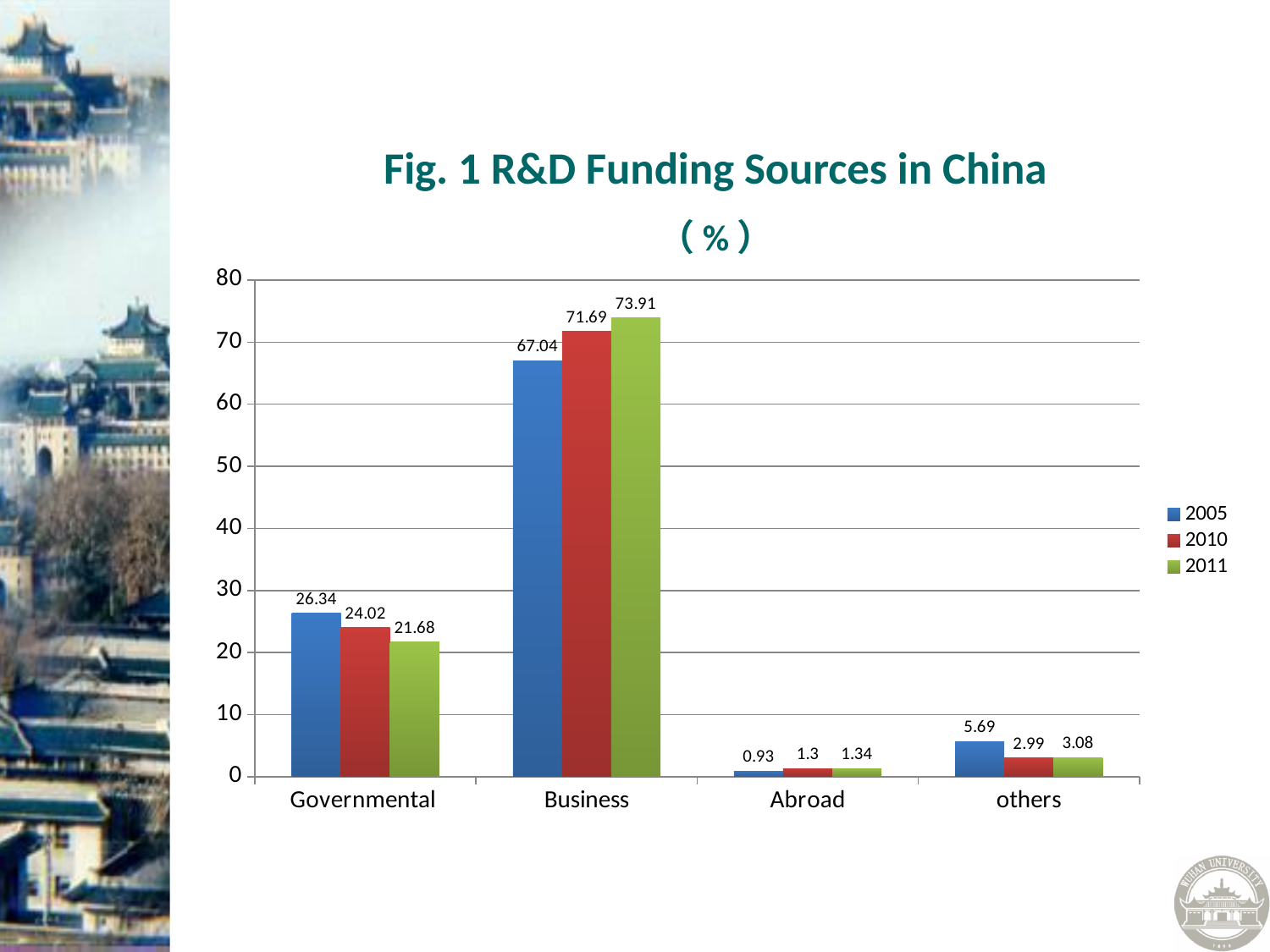
Which category has the highest value in 2010? Business What kind of chart is shown? bar chart Which category has the lowest value in 2005? Abroad What is the value for Business in 2011? 73.91 How many categories are shown on the x axis? 4 Which is larger, the 2005 value for others or the 2011 value for others? 2005 What is the value for Abroad in 2010? 1.3 What is the difference between the 2011 and 2005 values for Business? 6.87 What is the title of the chart? Fig. 1 R&D Funding Sources in China (%) Is the value for Governmental in 2011 greater or less than 30? less What is the value for Governmental in 2005? 26.34 How many series does the legend list? 3